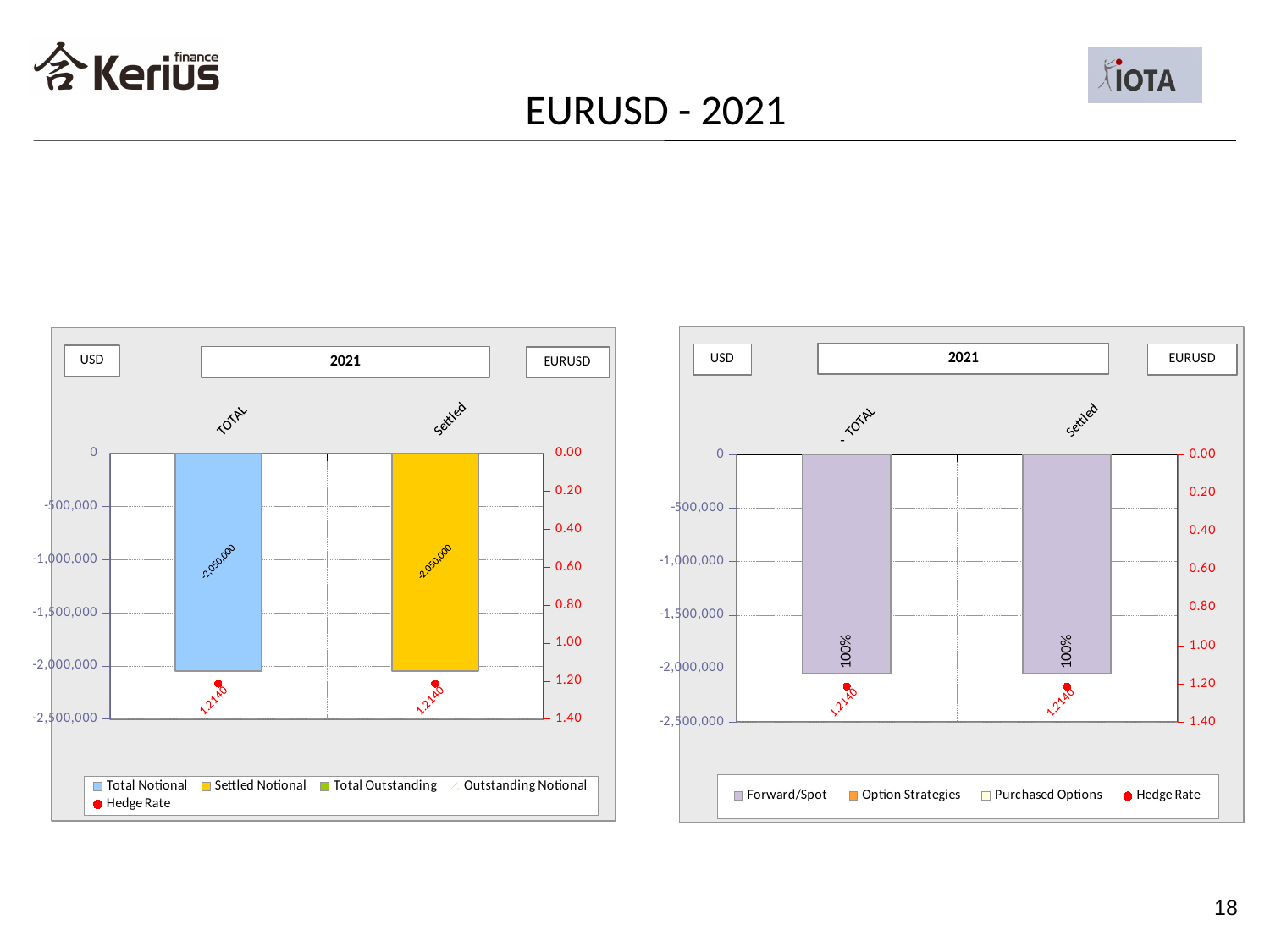
In the right chart, what Hedge Rate value is shown for Settled? 1.2140 In the left chart, which legend entry is shown in yellow? Settled Notional What type of chart is the right chart? Combination bar and line chart How many series does the legend of the left chart list? 5 How many series does the legend of the right chart list? 4 How many categories are shown on the x axis of the left chart? 2 In the left chart, what is the data label on the TOTAL bar? -2,050,000 In the left chart, what Hedge Rate value is shown for TOTAL? 1.2140 In the right chart, what percentage label is shown on the TOTAL bar? 100% In the right chart, what percentage label is shown on the Settled bar? 100% In the left chart, what is the difference between the TOTAL and Settled bar values? 0 In the left chart, what is the data label on the Settled bar? -2,050,000